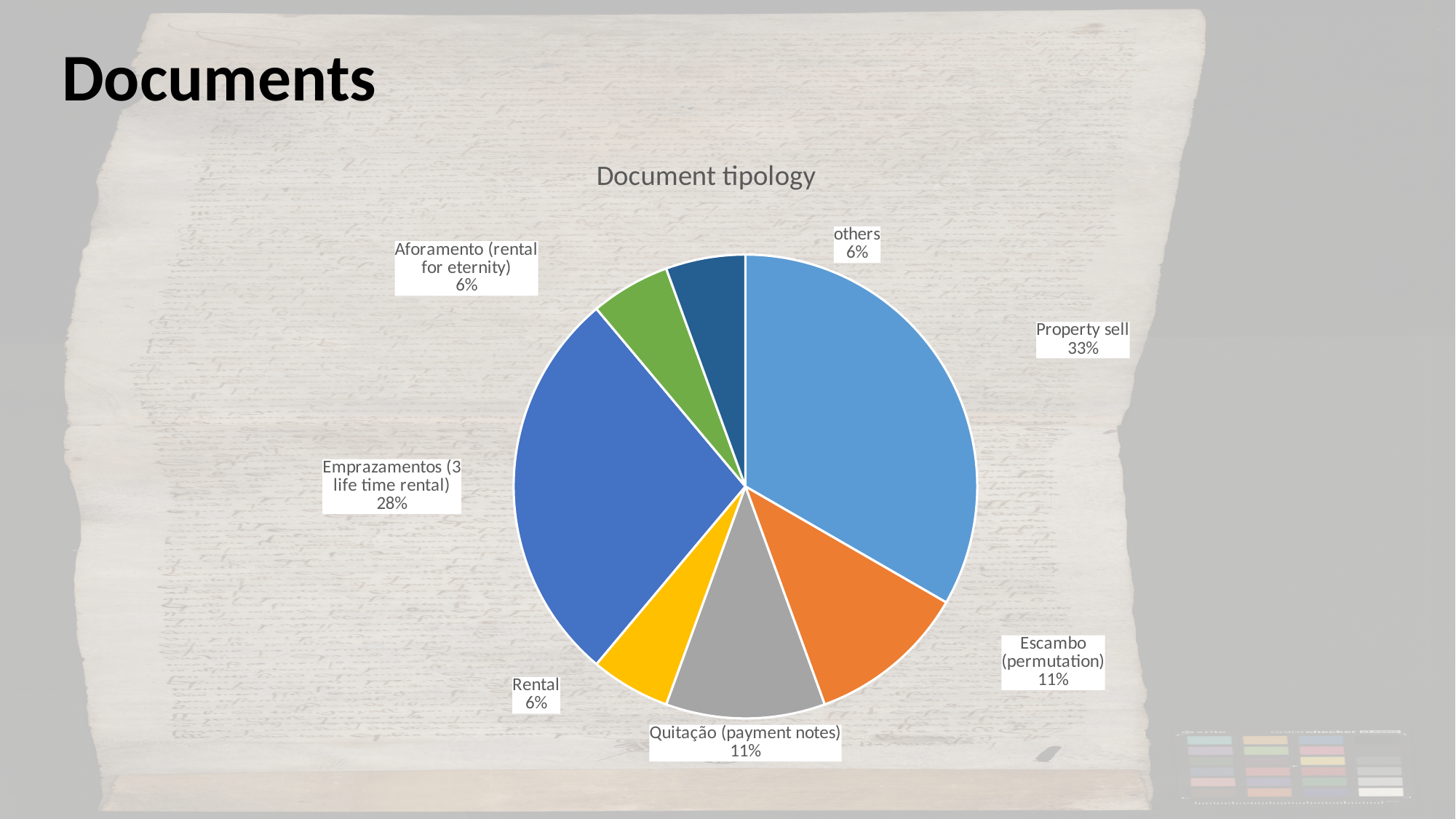
How many slices does the pie chart have? 7 What percentage is shown for Escambo (permutation)? 11% What percentage is shown for Rental? 6% Which is larger, the share for Property sell or the share for Emprazamentos (3 life time rental)? Property sell What percentage is shown for Aforamento (rental for eternity)? 6% What share of the pie does Property sell represent? 33% Which category has the largest slice of the pie? Property sell What percentage is shown for Quitação (payment notes)? 11% What type of chart is shown on the slide? pie chart What share of the pie does Emprazamentos (3 life time rental) represent? 28% What is the difference in percentage points between Property sell and Emprazamentos (3 life time rental)? 5 What is the title of the chart? Document tipology